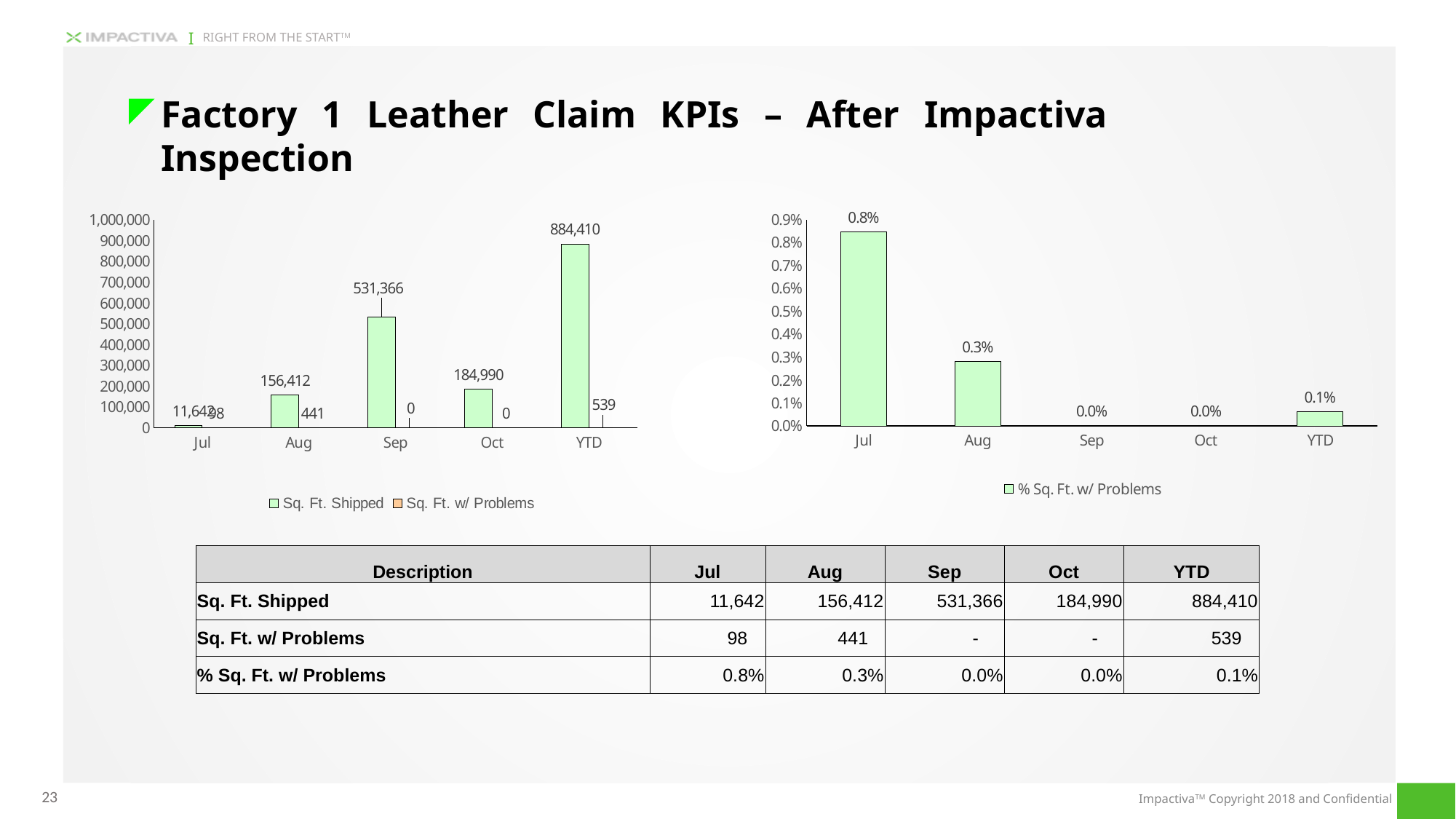
In the right chart, what is the % Sq. Ft. w/ Problems value for Jul? 0.8% In the left chart, what is the Sq. Ft. Shipped value for Sep? 531,366 In the left chart, which category has the highest Sq. Ft. Shipped value? YTD In the left chart, what is the Sq. Ft. w/ Problems value for Aug? 441 In the left chart, how many series does the legend list? 2 In the right chart, which category has the highest % Sq. Ft. w/ Problems value? Jul In the left chart, which month has the lowest Sq. Ft. Shipped value? Jul In the left chart, what is the difference between the Sq. Ft. Shipped values for Sep and Oct? 346,376 In the right chart, how many categories are shown on the x axis? 5 In the left chart, is the Sq. Ft. Shipped value for Oct greater or less than 200,000? less In the right chart, is the % Sq. Ft. w/ Problems value for Aug larger or smaller than the value for YTD? larger What type of chart is the right chart? bar chart